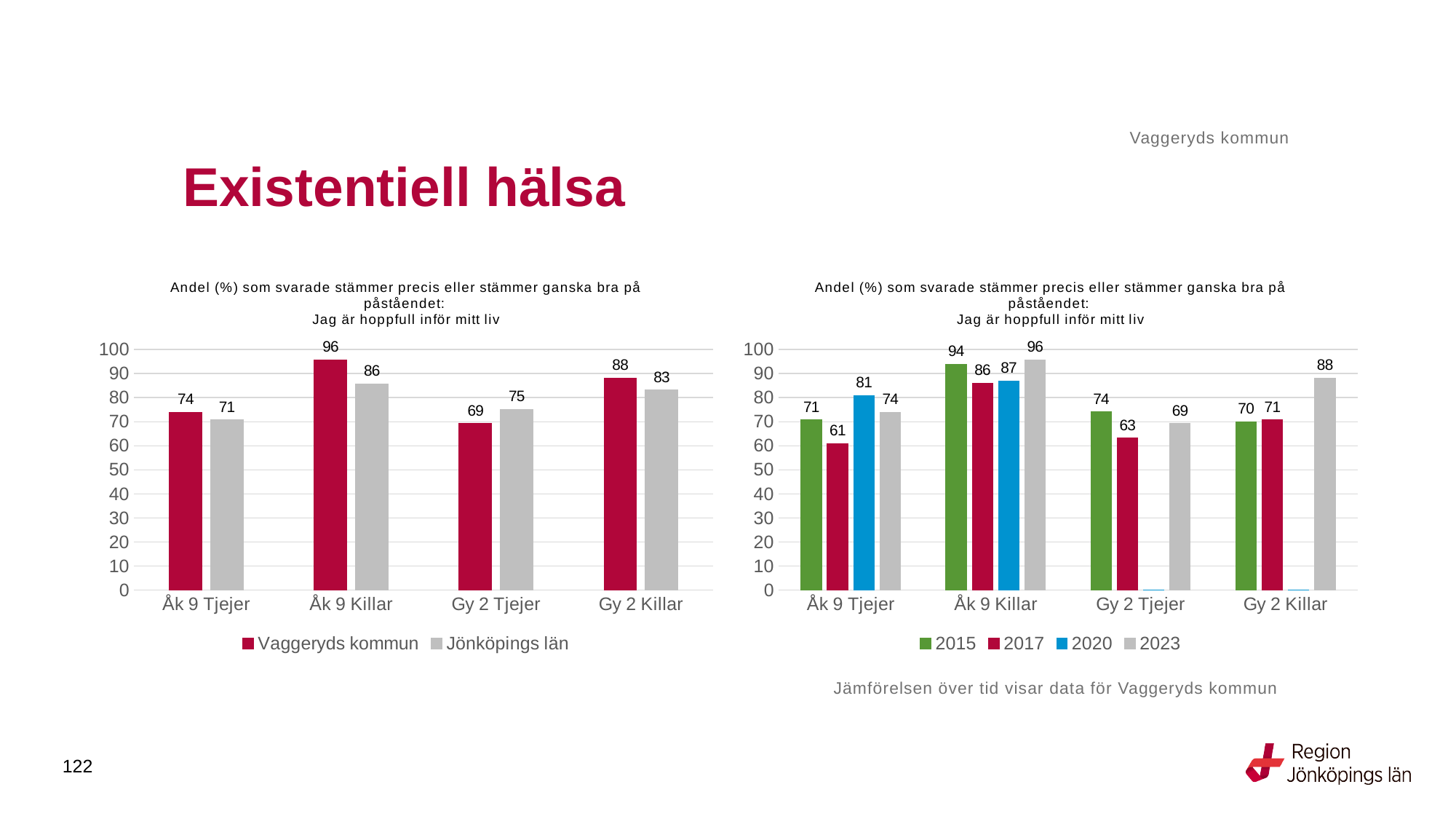
In the left chart, which category has the lowest value for Vaggeryds kommun? Gy 2 Tjejer What kind of chart is the right chart? Bar chart In the left chart, what is the value for Jönköpings län for Gy 2 Tjejer? 75 In the right chart, which year has the highest value for Åk 9 Killar? 2023 In the left chart, what is the value for Vaggeryds kommun for Åk 9 Killar? 96 How many series does the legend of the right chart list? 4 In the left chart, what is the difference between Vaggeryds kommun and Jönköpings län for Åk 9 Killar? 10 In the right chart, what is the value for 2020 for Åk 9 Tjejer? 81 In the right chart, what is the value for 2017 for Gy 2 Tjejer? 63 In the right chart, what is the difference between 2015 and 2017 for Åk 9 Tjejer? 10 How many series does the legend of the left chart list? 2 In the left chart, which is larger for Gy 2 Tjejer: Vaggeryds kommun or Jönköpings län? Jönköpings län